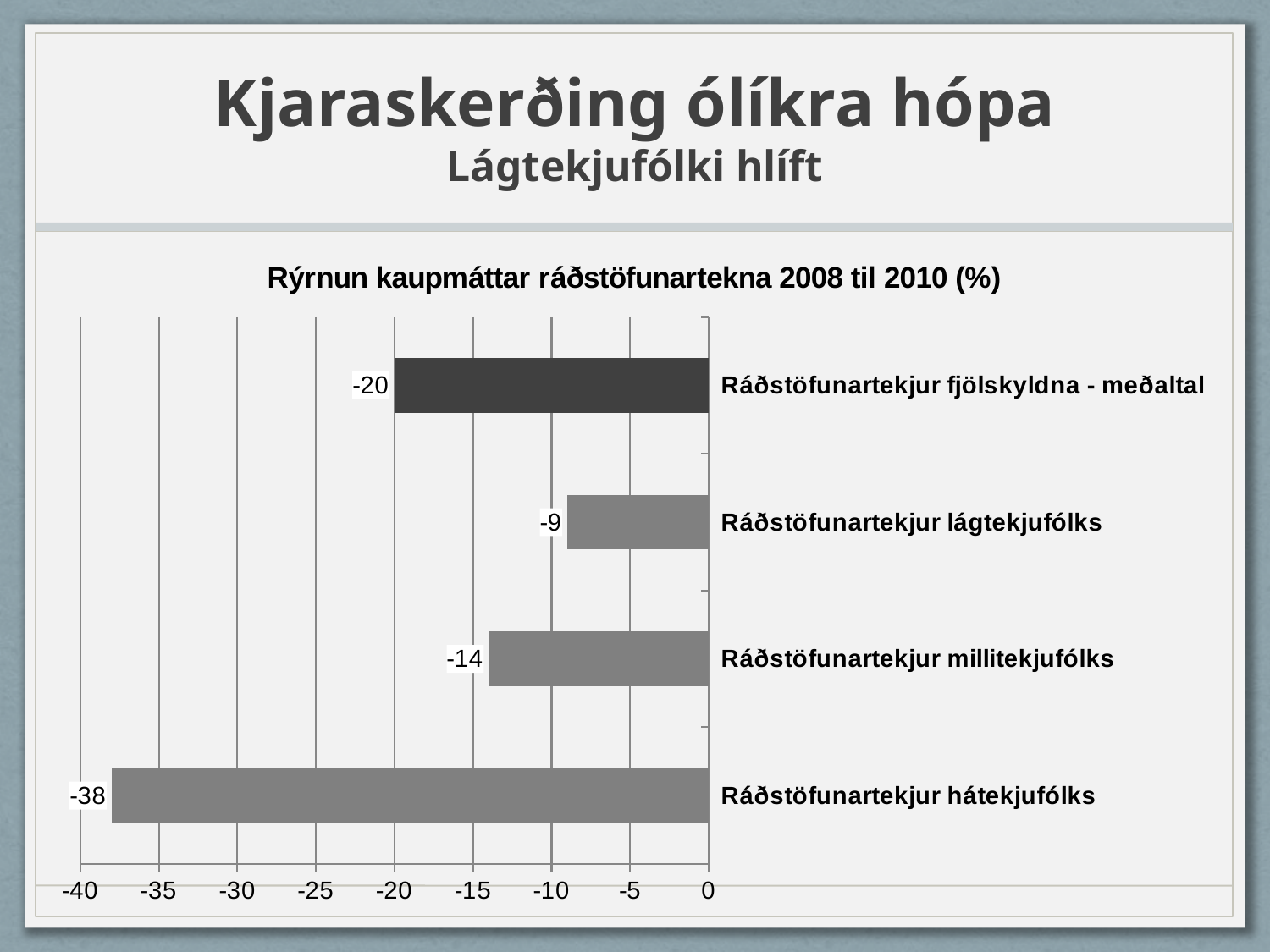
What is the title of the chart? Rýrnun kaupmáttar ráðstöfunartekna 2008 til 2010 (%) What is the value for Ráðstöfunartekjur lágtekjufólks? -9 What is the value for Ráðstöfunartekjur hátekjufólks? -38 Which category has the lowest (most negative) value? Ráðstöfunartekjur hátekjufólks What is the difference between the values for Ráðstöfunartekjur fjölskyldna - meðaltal and Ráðstöfunartekjur millitekjufólks? 6 What is the value for Ráðstöfunartekjur fjölskyldna - meðaltal? -20 How many categories are shown in the chart? 4 What kind of chart is shown on the slide? Bar chart Which has the larger (less negative) value: Ráðstöfunartekjur millitekjufólks or Ráðstöfunartekjur lágtekjufólks? Ráðstöfunartekjur lágtekjufólks Which category has the highest (least negative) value? Ráðstöfunartekjur lágtekjufólks What is the difference between the values for Ráðstöfunartekjur hátekjufólks and Ráðstöfunartekjur lágtekjufólks? 29 What is the value for Ráðstöfunartekjur millitekjufólks? -14